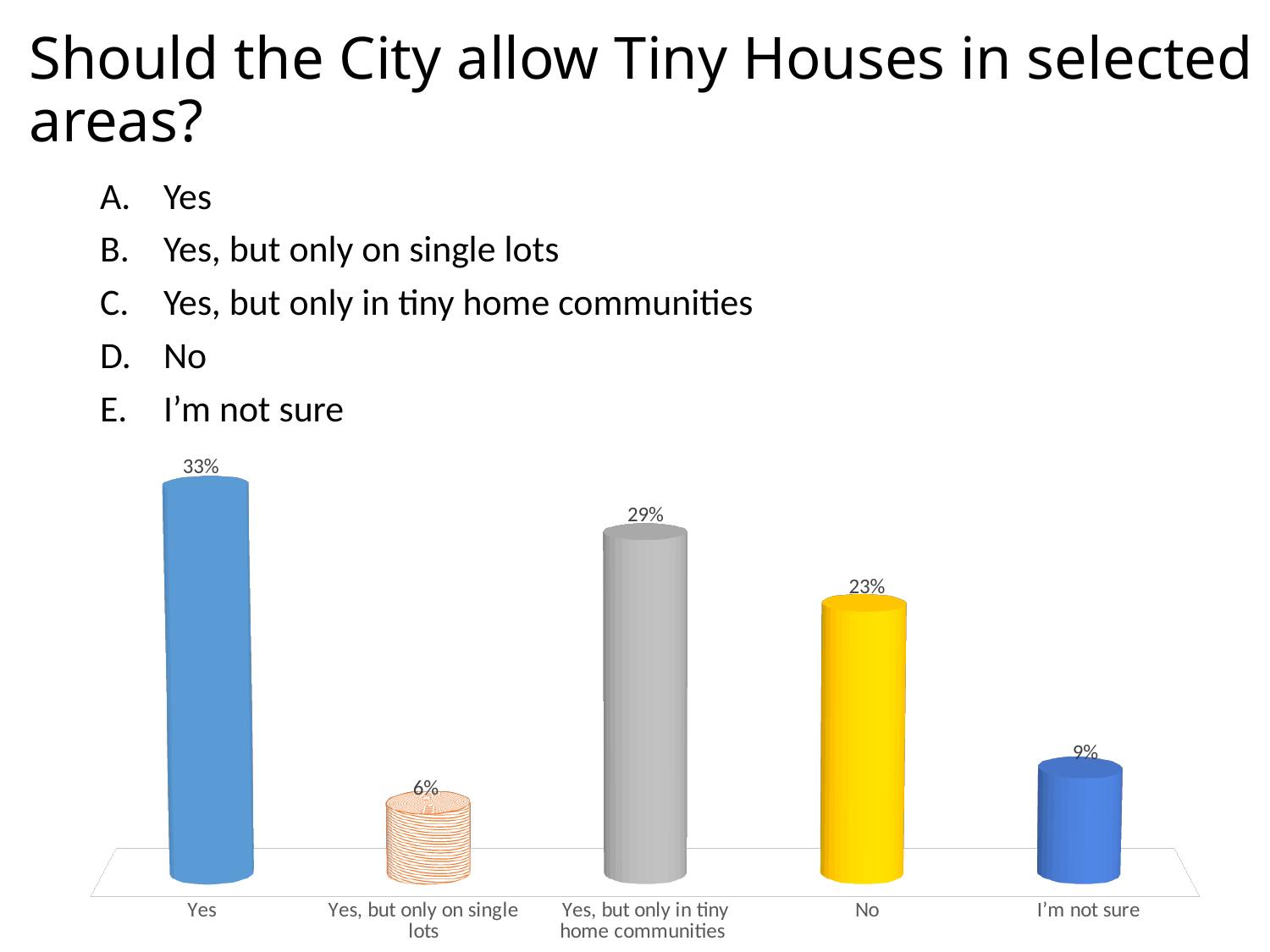
What percentage of respondents answered "Yes, but only on single lots"? 6% What is the difference in percentage points between "Yes" and "No"? 10 What percentage of respondents answered "No"? 23% Which is larger, the value for "No" or the value for "I'm not sure"? No What percentage of respondents answered "Yes"? 33% What kind of chart is shown on the slide? Bar chart Which response received the lowest percentage? Yes, but only on single lots What percentage of respondents answered "Yes, but only in tiny home communities"? 29% Which response received the highest percentage? Yes How many response categories are shown in the chart? 5 What colour is the bar for "No"? Yellow What percentage of respondents answered "I'm not sure"? 9%